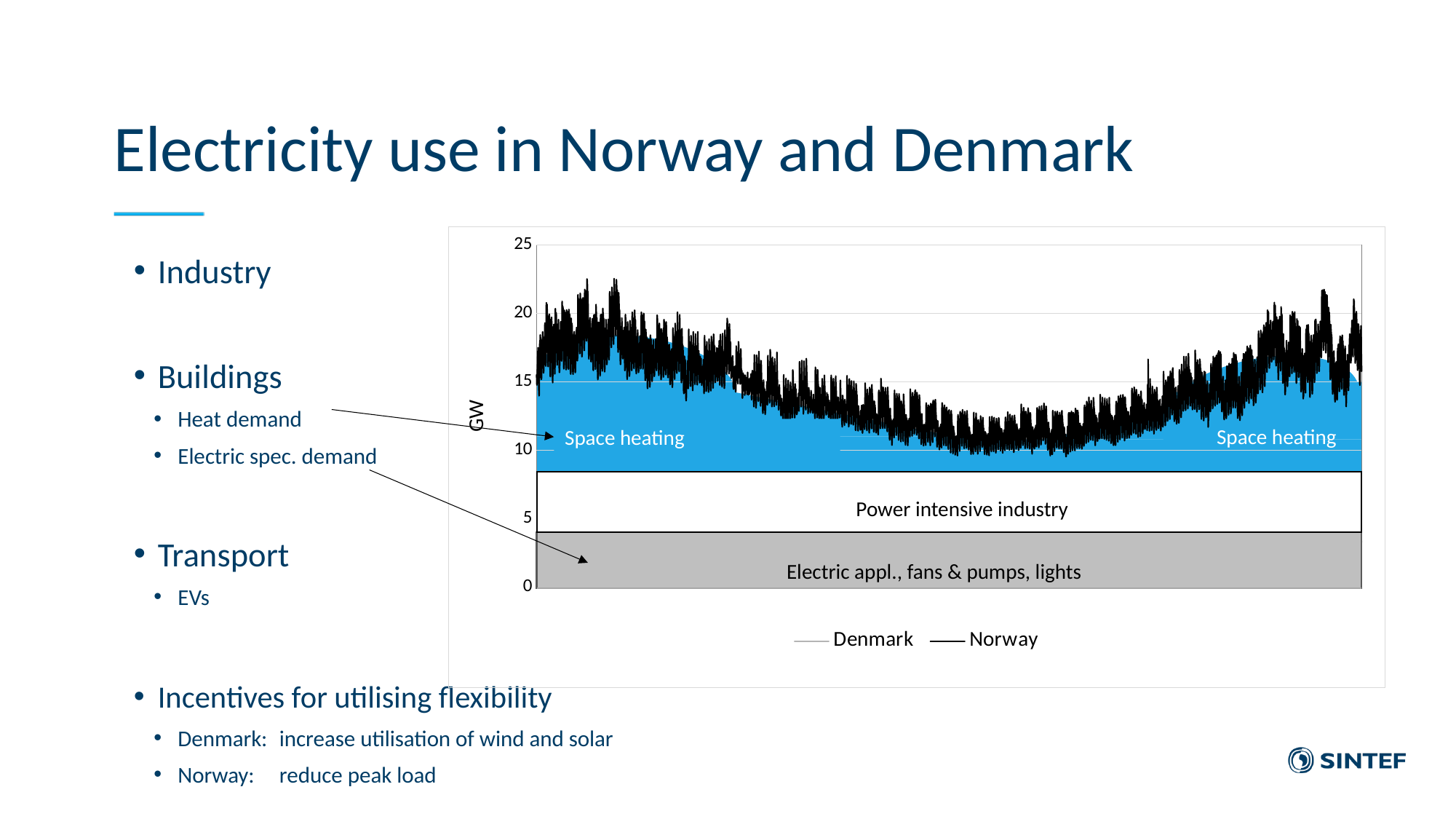
Is the peak value of the Norway line greater or less than 20? greater What kind of chart is shown on the slide? line chart Is the lowest point of the Norway line greater or less than 15? less What is the highest value shown on the vertical axis of the chart? 25 Does the Norway line rise or fall from the left edge of the chart toward the middle? fall What is the label on the vertical axis of the chart? GW Which series in the chart is drawn in black? Norway How many series does the chart legend list? 2 Which two series are listed in the chart legend? Denmark and Norway Does the Norway line rise or fall from the middle of the chart toward the right edge? rise